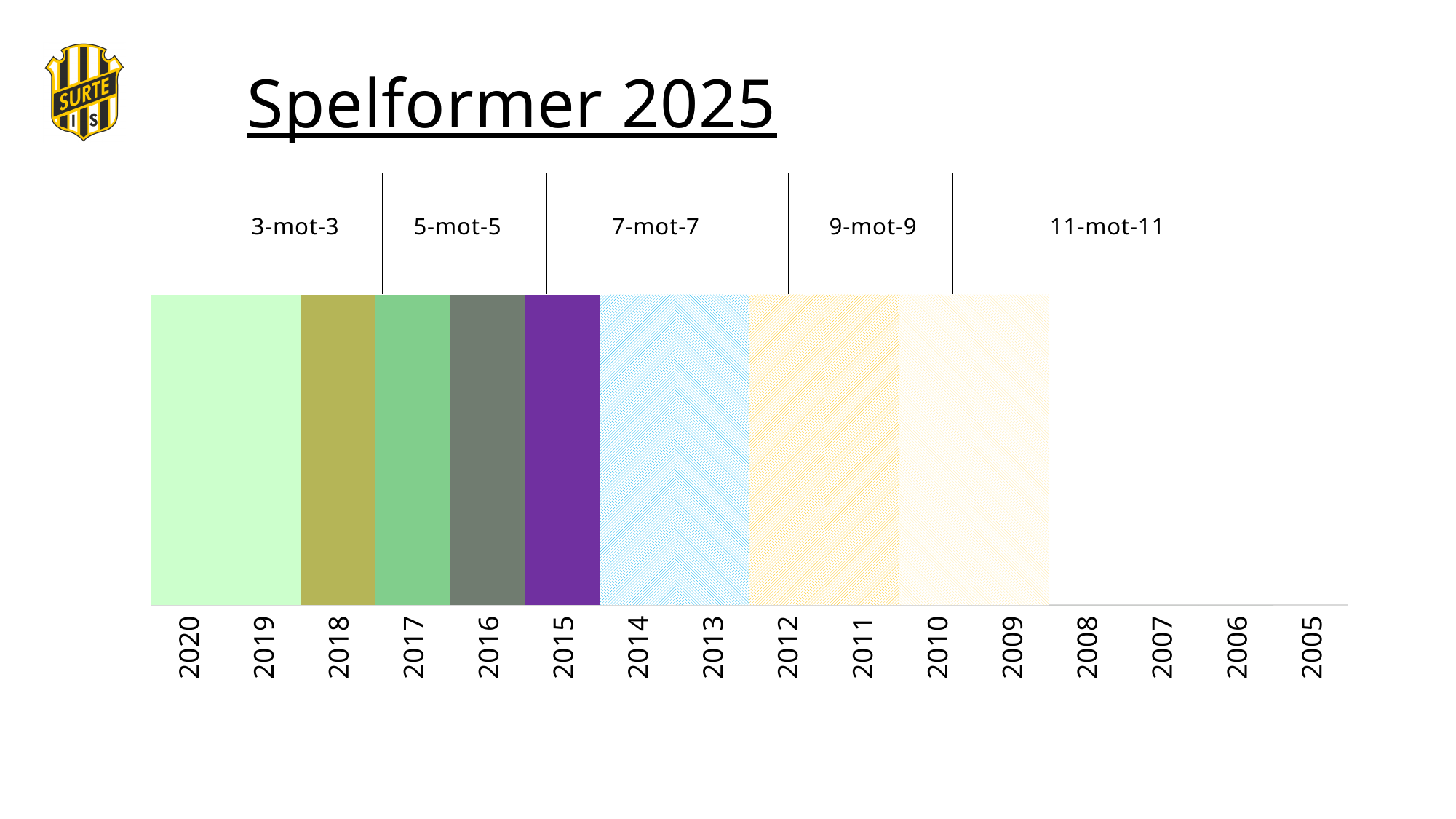
What kind of chart is shown on the slide? bar chart Which game format label is placed above the bars for 2010 and 2009? 11-mot-11 Which game format label is placed above the bars for 2020 and 2019? 3-mot-3 How many game format labels are shown above the chart? 5 What is the title of the slide? Spelformer 2025 How many year categories are listed along the x axis? 16 Which game format label is placed above the bars for 2015, 2014 and 2013? 7-mot-7 Which years on the x axis have no bar drawn? 2008, 2007, 2006, 2005 Is the bar for 2020 taller than the bar for 2008? Yes Which game format label is placed above the bars for 2017 and 2016? 5-mot-5 Which is the earliest year shown on the x axis? 2005 Which game format label is placed above the bars for 2012 and 2011? 9-mot-9